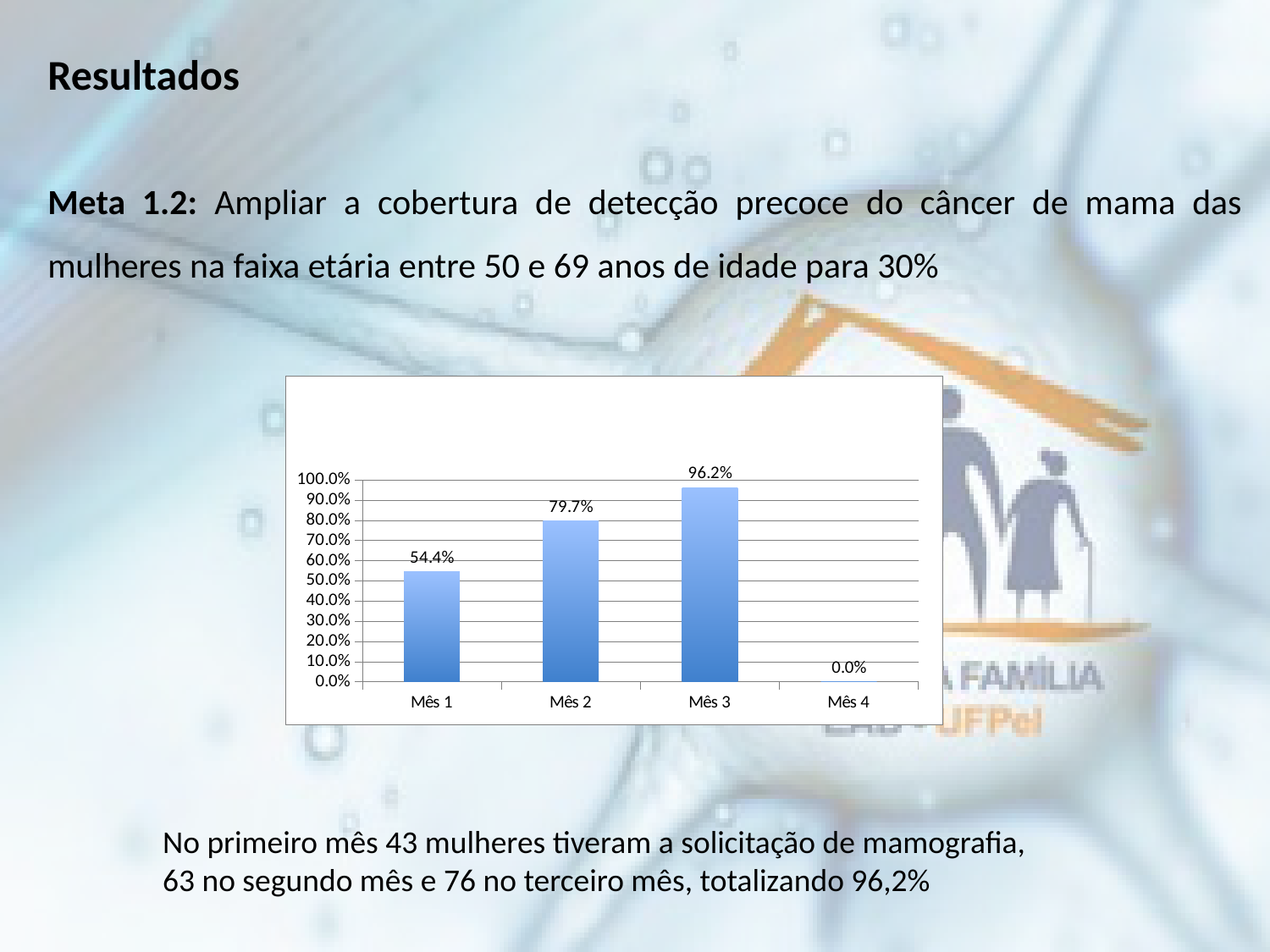
How many categories are shown on the x axis? 4 What is the value for Mês 4? 0.0% What is the difference between the values for Mês 2 and Mês 1? 25.3% Is the value for Mês 2 greater or less than 70.0%? greater What is the value for Mês 3? 96.2% Which is larger, the value for Mês 2 or the value for Mês 1? Mês 2 What kind of chart is shown on the slide? bar chart Which category has the highest value? Mês 3 What is the value for Mês 1? 54.4% What is the value for Mês 2? 79.7% Which category has the lowest value? Mês 4 What is the difference between the values for Mês 3 and Mês 1? 41.8%